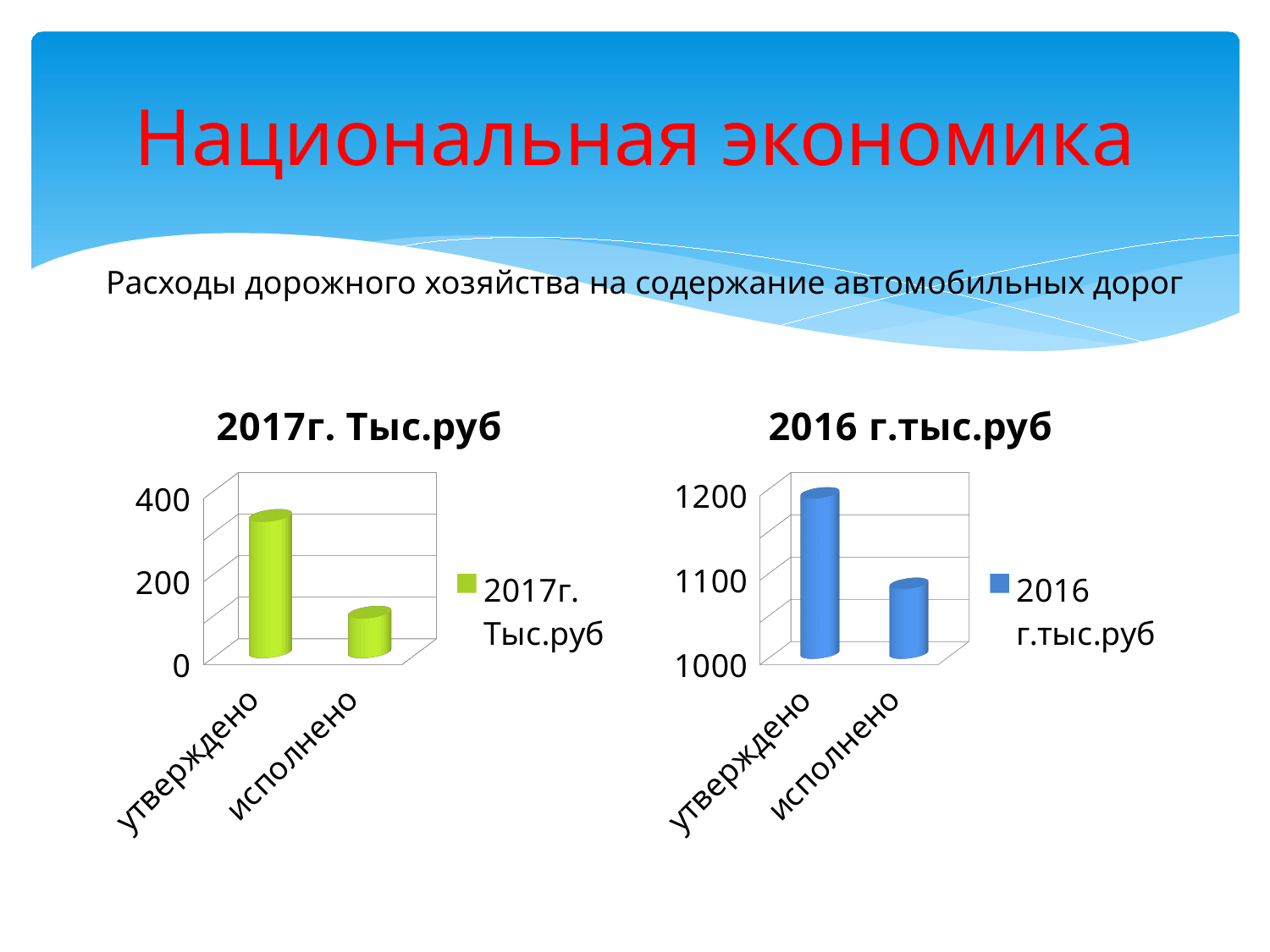
In the chart titled "2016 г.тыс.руб", which is larger, утверждено or исполнено? утверждено How many categories are shown on the x axis of the chart titled "2017г. Тыс.руб"? 2 In the chart titled "2016 г.тыс.руб", is the value for утверждено greater or less than 1100? greater In the chart titled "2016 г.тыс.руб", which category has the highest value? утверждено In the chart titled "2017г. Тыс.руб", is the value for исполнено greater or less than 200? less In the chart titled "2017г. Тыс.руб", which category has the lowest value? исполнено In the chart titled "2017г. Тыс.руб", is the value for утверждено greater or less than 200? greater What kind of chart is the chart titled "2016 г.тыс.руб"? bar chart What is the legend entry of the chart on the left of the slide? 2017г. Тыс.руб What colour are the bars in the chart titled "2016 г.тыс.руб"? blue In the chart titled "2017г. Тыс.руб", which category has the highest value? утверждено How many series does the legend of the chart titled "2016 г.тыс.руб" list? 1